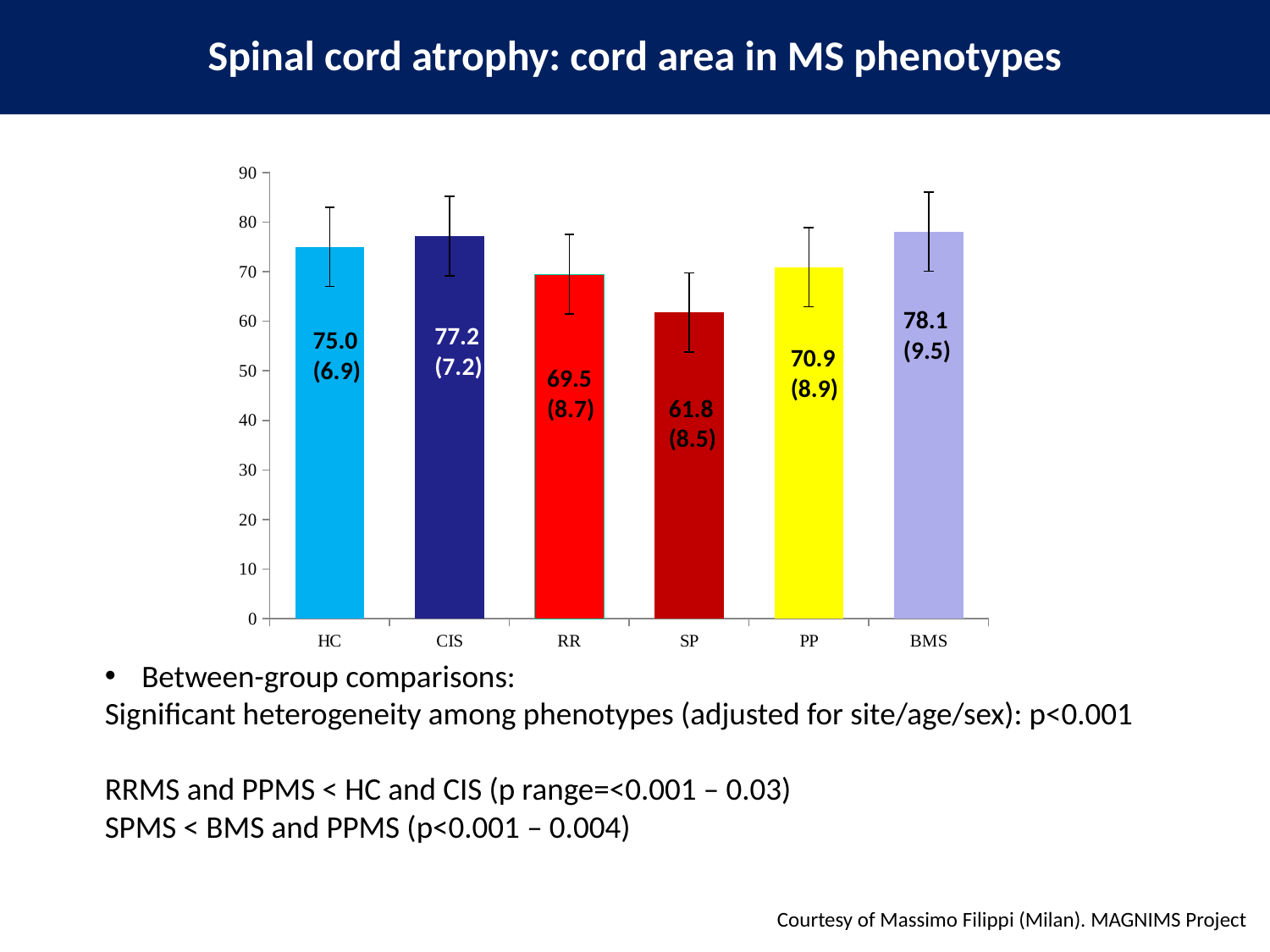
What is the difference between the cord area values for HC and SP? 13.2 What is the cord area value for BMS? 78.1 What is the cord area value for HC? 75.0 How many phenotype categories are shown on the x axis? 6 What type of chart is shown on the slide? bar chart Which has a larger cord area, PP or RR? PP Is the value for SP greater or less than 70? less What is the value shown in parentheses for PP? 8.9 Which phenotype has the lowest cord area? SP What is the cord area value for SP? 61.8 What is the difference between the cord area values for CIS and RR? 7.7 Which phenotype has the highest cord area? BMS